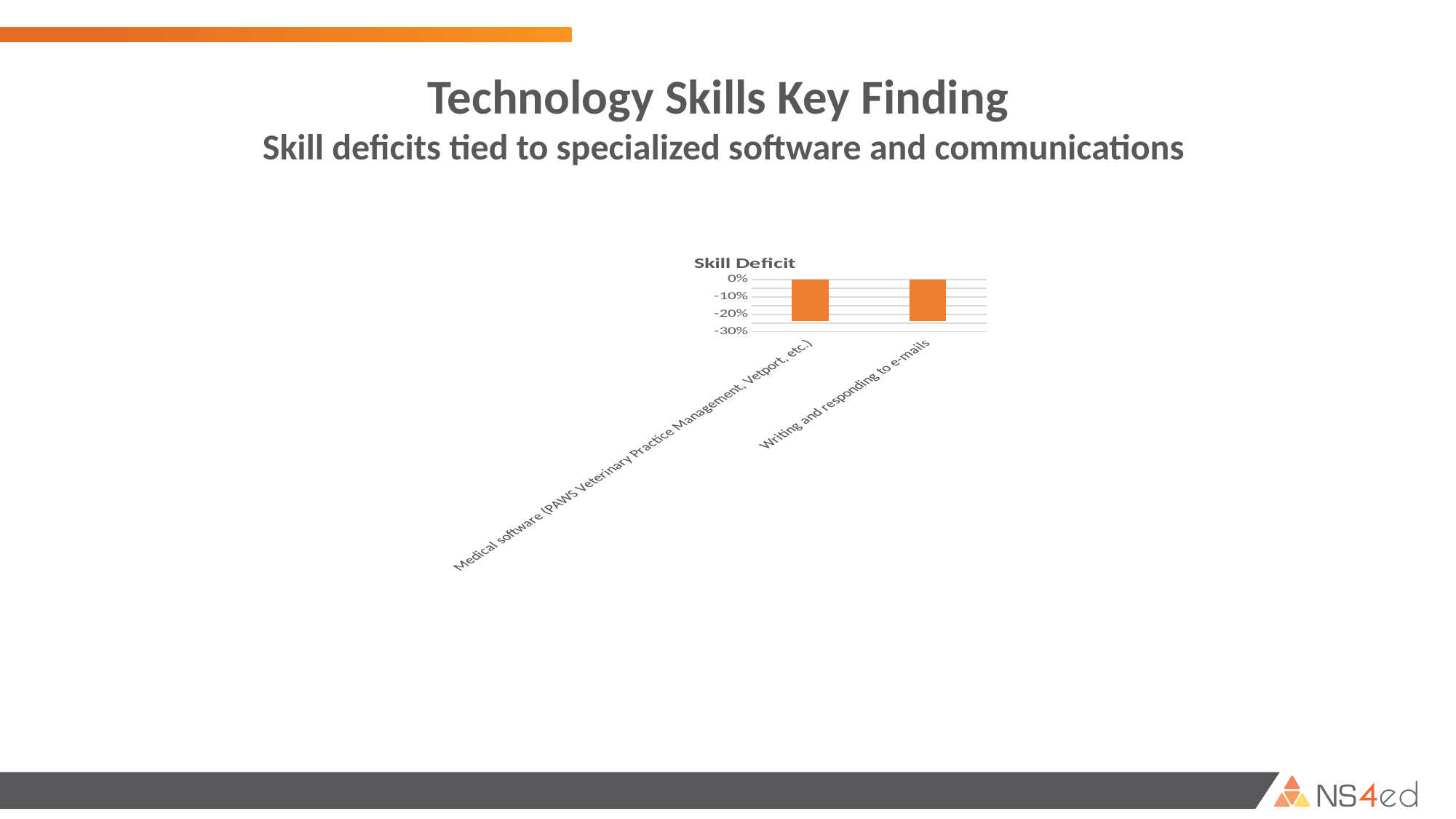
Is the value for Medical software (PAWS Veterinary Practice Management, Vetport, etc.) greater or less than -30%? greater Is the value for Medical software (PAWS Veterinary Practice Management, Vetport, etc.) greater or less than -10%? less What kind of chart is shown on the slide? bar chart What is the lowest value shown on the vertical axis of the Skill Deficit chart? -30% Is the value for Writing and responding to e-mails greater or less than -30%? greater What colour are the bars in the Skill Deficit chart? orange How many categories are plotted in the Skill Deficit chart? 2 What is the title of the chart on the slide? Skill Deficit